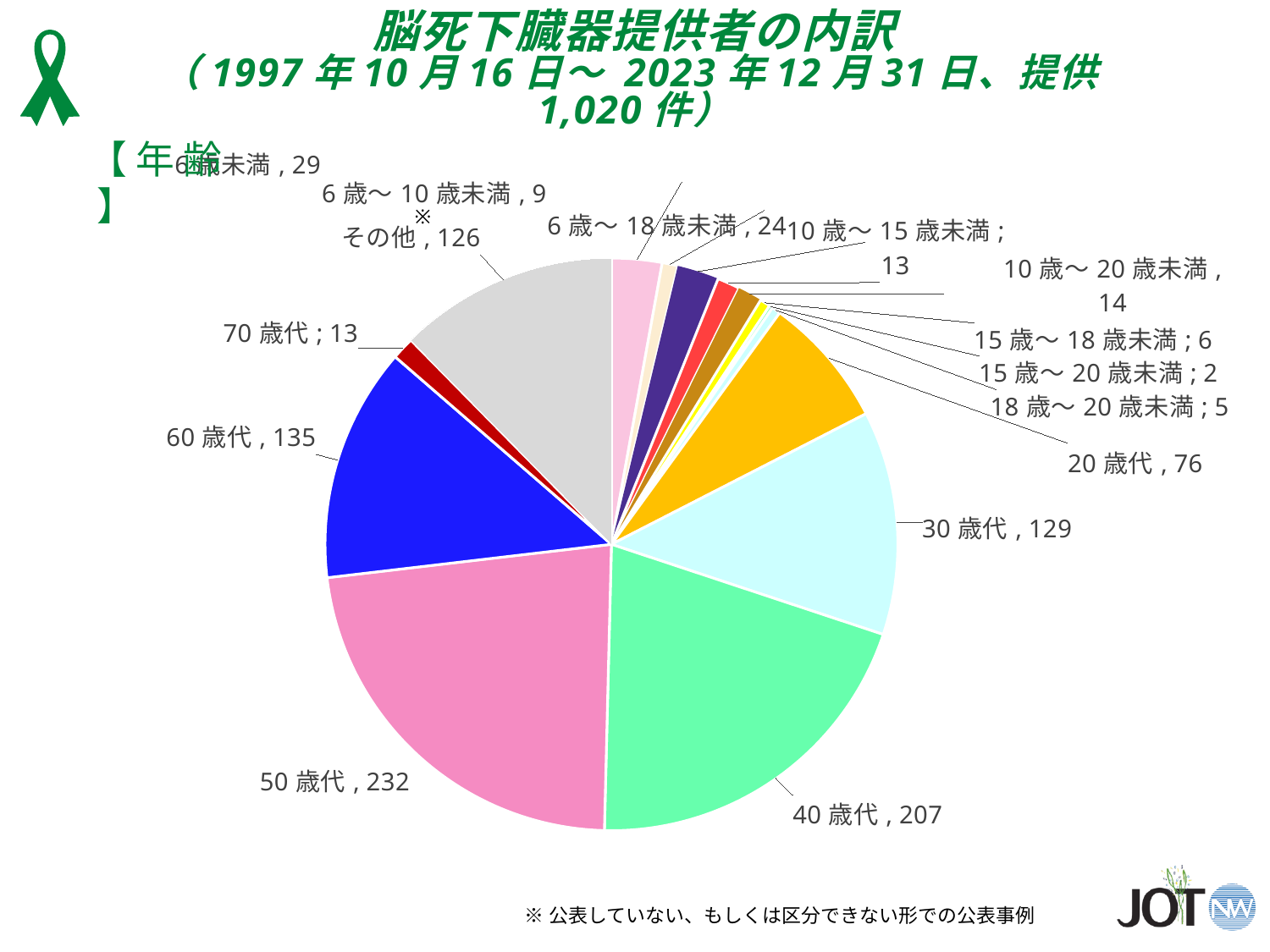
What is the total number of donations stated in the chart title? 1,020 件 Which age category has the largest slice in the pie chart? 50歳代 What is the difference between the values for 50歳代 and 40歳代? 25 What is the value for 40歳代 in the pie chart? 207 What is the value for 50歳代 in the pie chart? 232 What type of chart is shown on the slide? pie chart What is the difference between the values for 6歳未満 and 6歳～10歳未満? 20 Which age category has the smallest slice in the pie chart? 15歳～20歳未満 What is the value for 15歳～20歳未満 in the pie chart? 2 Which is larger, the value for 60歳代 or the value for 30歳代? 60歳代 How many categories are shown in the pie chart? 15 What is the value for その他 in the pie chart? 126